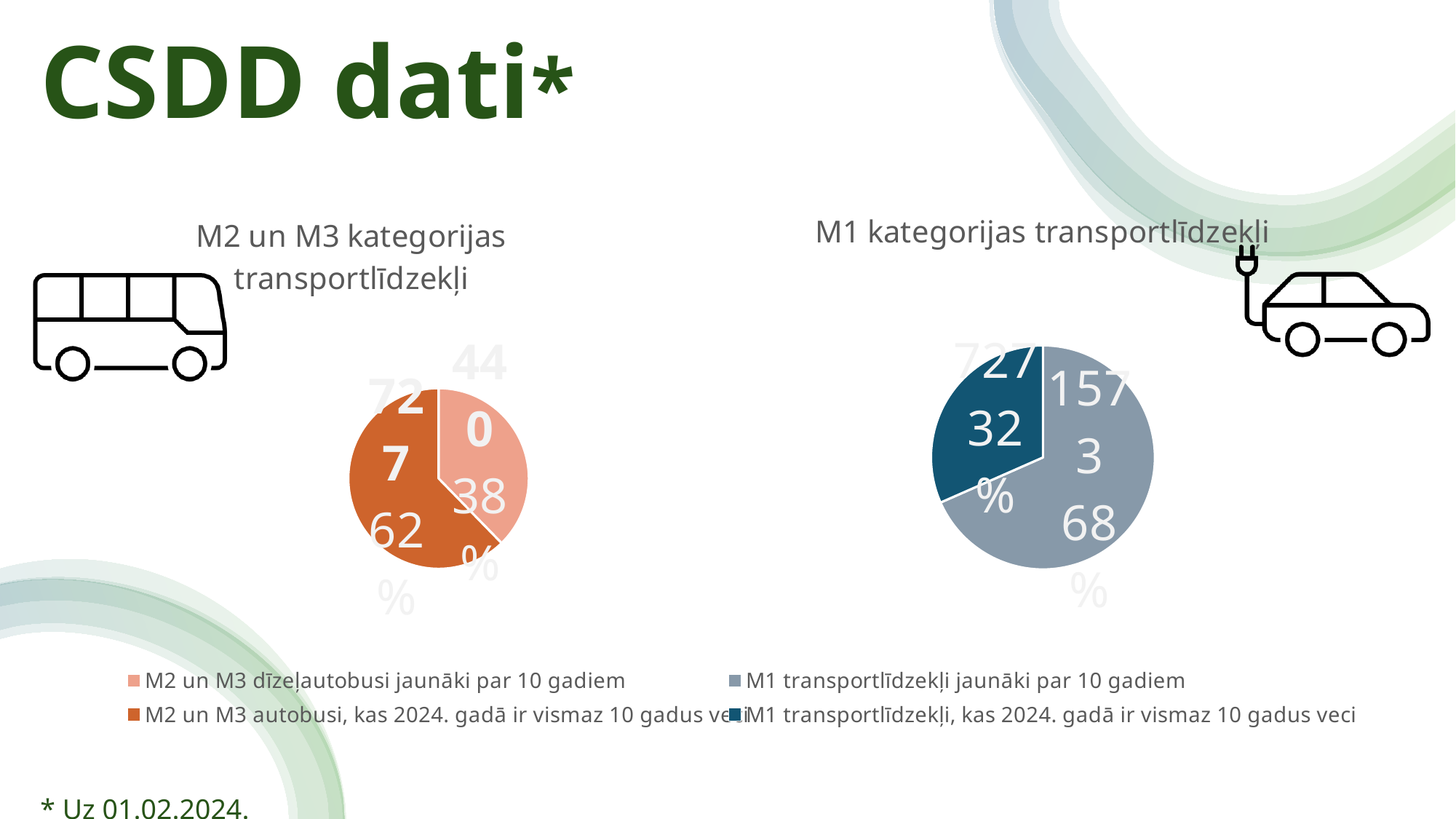
What kind of chart is the 'M2 un M3 kategorijas transportlīdzekļi' chart? pie chart In the 'M1 kategorijas transportlīdzekļi' chart, what is the value for 'M1 transportlīdzekļi jaunāki par 10 gadiem'? 1573 In the 'M2 un M3 kategorijas transportlīdzekļi' chart, what is the value for 'M2 un M3 autobusi, kas 2024. gadā ir vismaz 10 gadus veci'? 727 In the 'M1 kategorijas transportlīdzekļi' chart, which is larger: 'M1 transportlīdzekļi jaunāki par 10 gadiem' or 'M1 transportlīdzekļi, kas 2024. gadā ir vismaz 10 gadus veci'? M1 transportlīdzekļi jaunāki par 10 gadiem In the 'M2 un M3 kategorijas transportlīdzekļi' chart, which slice is the largest? M2 un M3 autobusi, kas 2024. gadā ir vismaz 10 gadus veci In the 'M2 un M3 kategorijas transportlīdzekļi' chart, what share of the pie is 'M2 un M3 dīzeļautobusi jaunāki par 10 gadiem'? 38% In the 'M1 kategorijas transportlīdzekļi' chart, what share of the pie is 'M1 transportlīdzekļi, kas 2024. gadā ir vismaz 10 gadus veci'? 32% How many slices does the 'M1 kategorijas transportlīdzekļi' pie chart have? 2 In the 'M1 kategorijas transportlīdzekļi' chart, what share of the pie is 'M1 transportlīdzekļi jaunāki par 10 gadiem'? 68% How many pie charts are shown on the slide? 2 In the 'M1 kategorijas transportlīdzekļi' chart, which slice is the smallest? M1 transportlīdzekļi, kas 2024. gadā ir vismaz 10 gadus veci